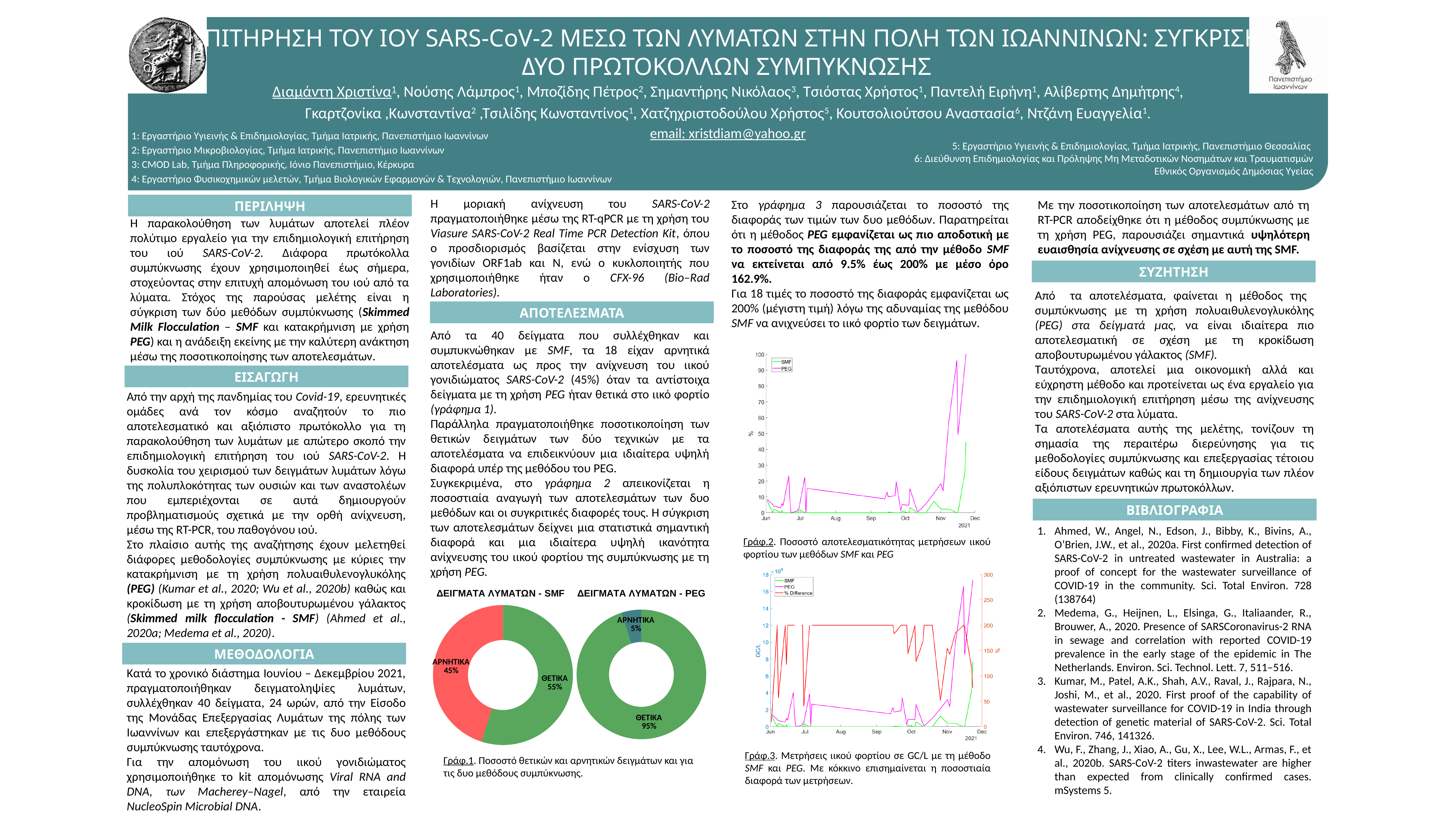
In the donut chart titled ΔΕΙΓΜΑΤΑ ΛΥΜΑΤΩΝ - SMF, what share of samples is ΘΕΤΙΚΑ? 55% In the donut chart titled ΔΕΙΓΜΑΤΑ ΛΥΜΑΤΩΝ - SMF, what share of samples is ΑΡΝΗΤΙΚΑ? 45% How many slices does the donut chart titled ΔΕΙΓΜΑΤΑ ΛΥΜΑΤΩΝ - SMF have? 2 In Γράφ.2, is the highest value of the PEG line greater or less than 90? greater In the donut chart titled ΔΕΙΓΜΑΤΑ ΛΥΜΑΤΩΝ - PEG, what share of samples is ΑΡΝΗΤΙΚΑ? 5% How many series does the legend of Γράφ.2 list? 2 Comparing the two donut charts, which method has the larger ΘΕΤΙΚΑ share, SMF or PEG? PEG How many series does the legend of Γράφ.3 list? 3 In Γράφ.2, is the highest value of the SMF line greater or less than 50? less What is the difference between the ΘΕΤΙΚΑ share in the PEG donut chart and the ΘΕΤΙΚΑ share in the SMF donut chart? 40% What kind of chart is Γράφ.2 (the chart with the % axis from 0 to 100)? Line chart